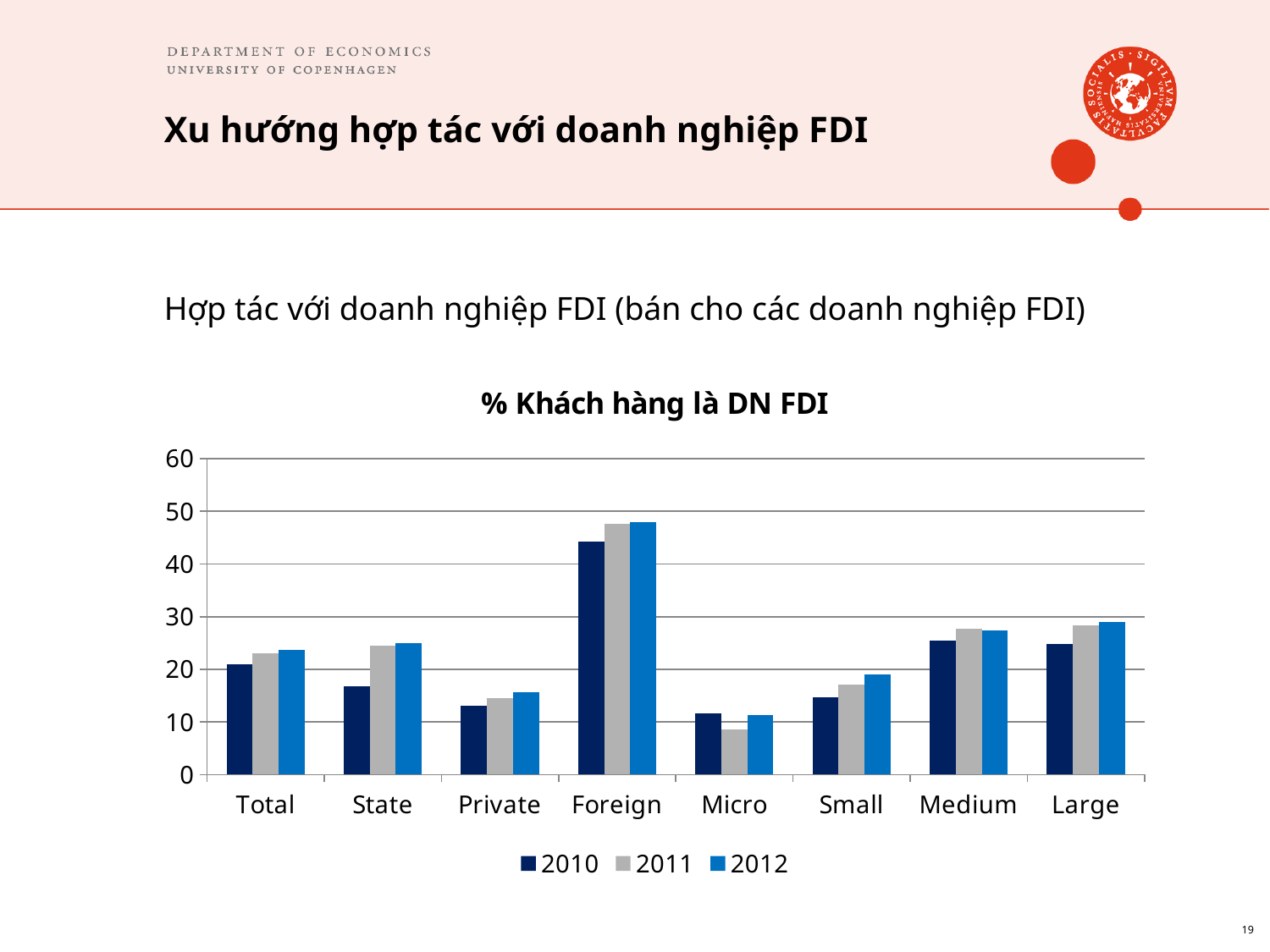
Which category has the highest value for 2012? Foreign Which category has the lowest value for 2011? Micro Is the value for Foreign in 2010 greater or less than 40? greater What kind of chart is shown on the slide? Bar chart Is the value for Micro in 2011 greater or less than 10? less Which is larger for 2010: the value for State or the value for Private? State How many categories are shown on the x axis of the chart? 8 What are the entries listed in the chart's legend? 2010, 2011, 2012 What is the title of the chart? % Khách hàng là DN FDI How many series does the legend list? 3 Which is larger for 2012: the value for Small or the value for Private? Small Is the value for Total in 2012 greater or less than 20? greater